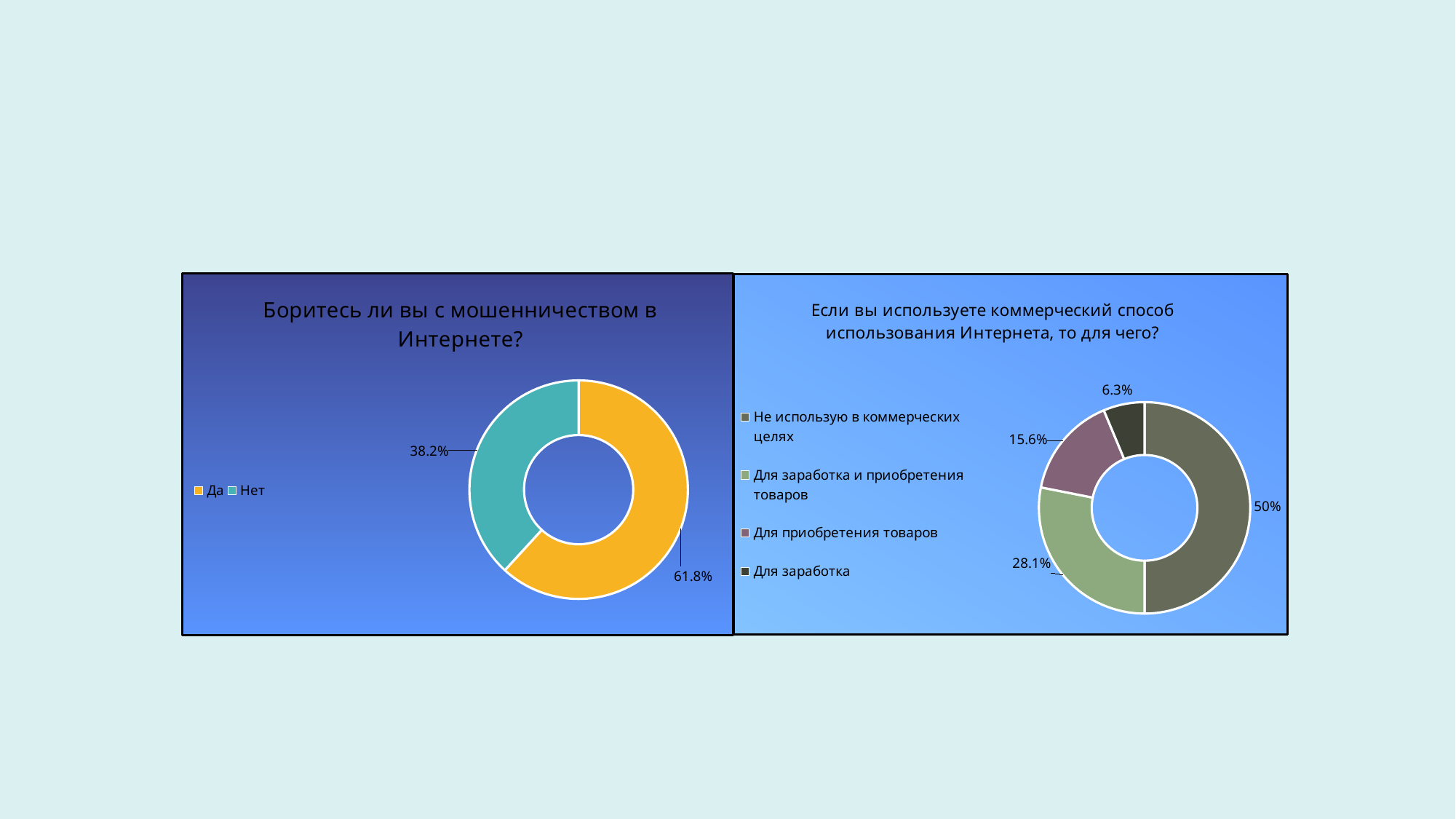
In the left chart 'Боритесь ли вы с мошенничеством в Интернете?', how many categories does the legend list? 2 In the right chart 'Если вы используете коммерческий способ использования Интернета, то для чего?', what is the value for 'Для заработка и приобретения товаров'? 28.1% In the right chart 'Если вы используете коммерческий способ использования Интернета, то для чего?', what is the value for 'Для заработка'? 6.3% In the left chart 'Боритесь ли вы с мошенничеством в Интернете?', what is the value for 'Нет'? 38.2% In the right chart 'Если вы используете коммерческий способ использования Интернета, то для чего?', which is larger: 'Для приобретения товаров' or 'Для заработка и приобретения товаров'? Для заработка и приобретения товаров What kind of chart is the left chart 'Боритесь ли вы с мошенничеством в Интернете?'? Doughnut chart In the left chart 'Боритесь ли вы с мошенничеством в Интернете?', what is the difference between 'Да' and 'Нет'? 23.6% In the left chart 'Боритесь ли вы с мошенничеством в Интернете?', what is the value for 'Да'? 61.8% In the right chart 'Если вы используете коммерческий способ использования Интернета, то для чего?', what is the value for 'Не использую в коммерческих целях'? 50% In the right chart 'Если вы используете коммерческий способ использования Интернета, то для чего?', which category has the smallest share? Для заработка In the right chart 'Если вы используете коммерческий способ использования Интернета, то для чего?', how many categories does the legend list? 4 In the left chart 'Боритесь ли вы с мошенничеством в Интернете?', which category has the largest share? Да